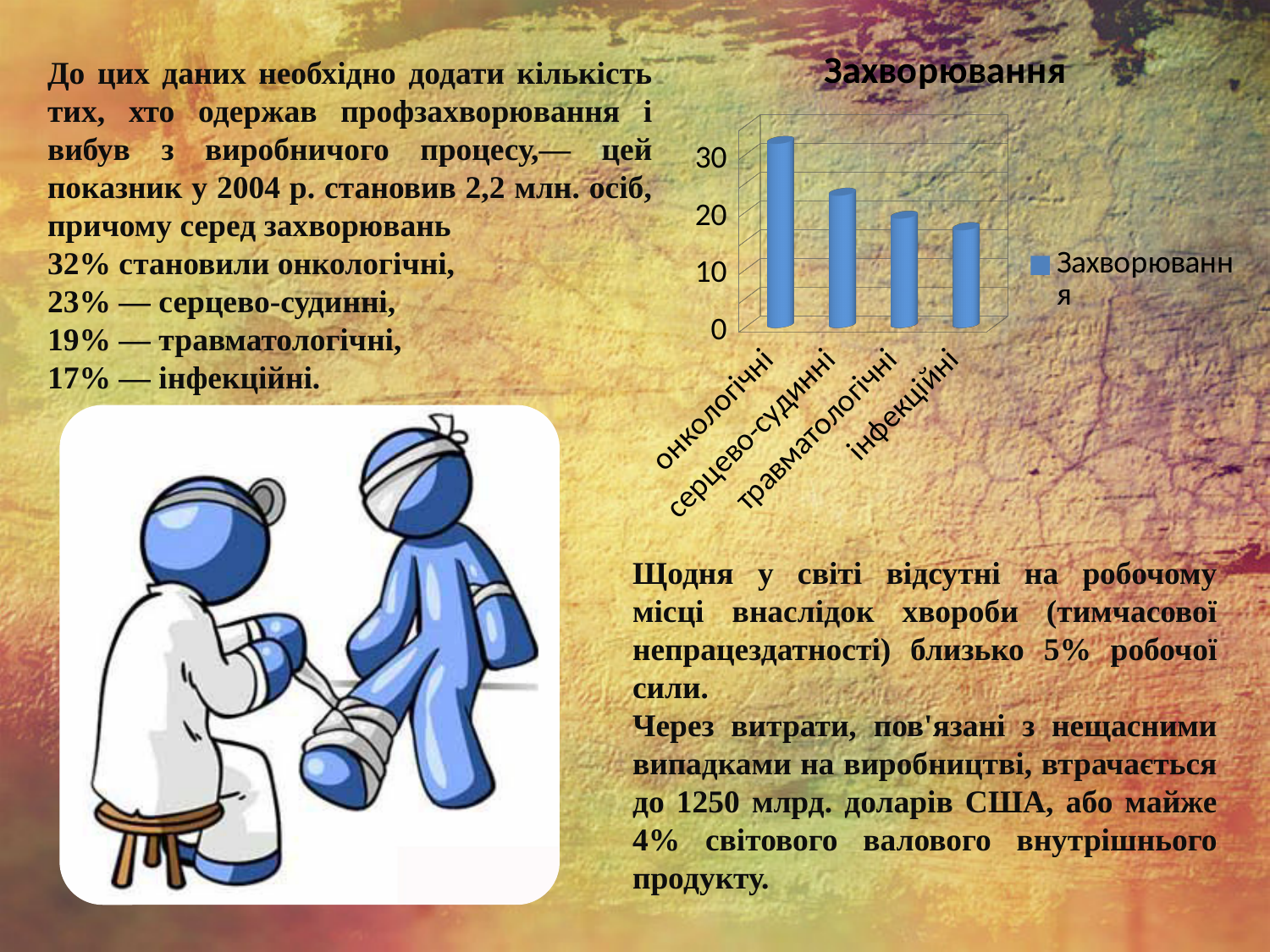
What is the title of the chart? Захворювання Do the bar values rise or fall from left to right along the x axis? fall Is the value for онкологічні greater or less than 20? greater Which category has the highest bar in the chart? онкологічні What kind of chart is shown on the slide? bar chart How many series does the chart legend list? 1 Which category has the lowest bar in the chart? інфекційні Which is larger in the chart, the value for онкологічні or the value for інфекційні? онкологічні How many categories are shown on the x axis of the chart? 4 Is the value for інфекційні greater or less than 20? less Which is larger in the chart, the value for серцево-судинні or the value for травматологічні? серцево-судинні What is the name of the series shown in the chart legend? Захворювання